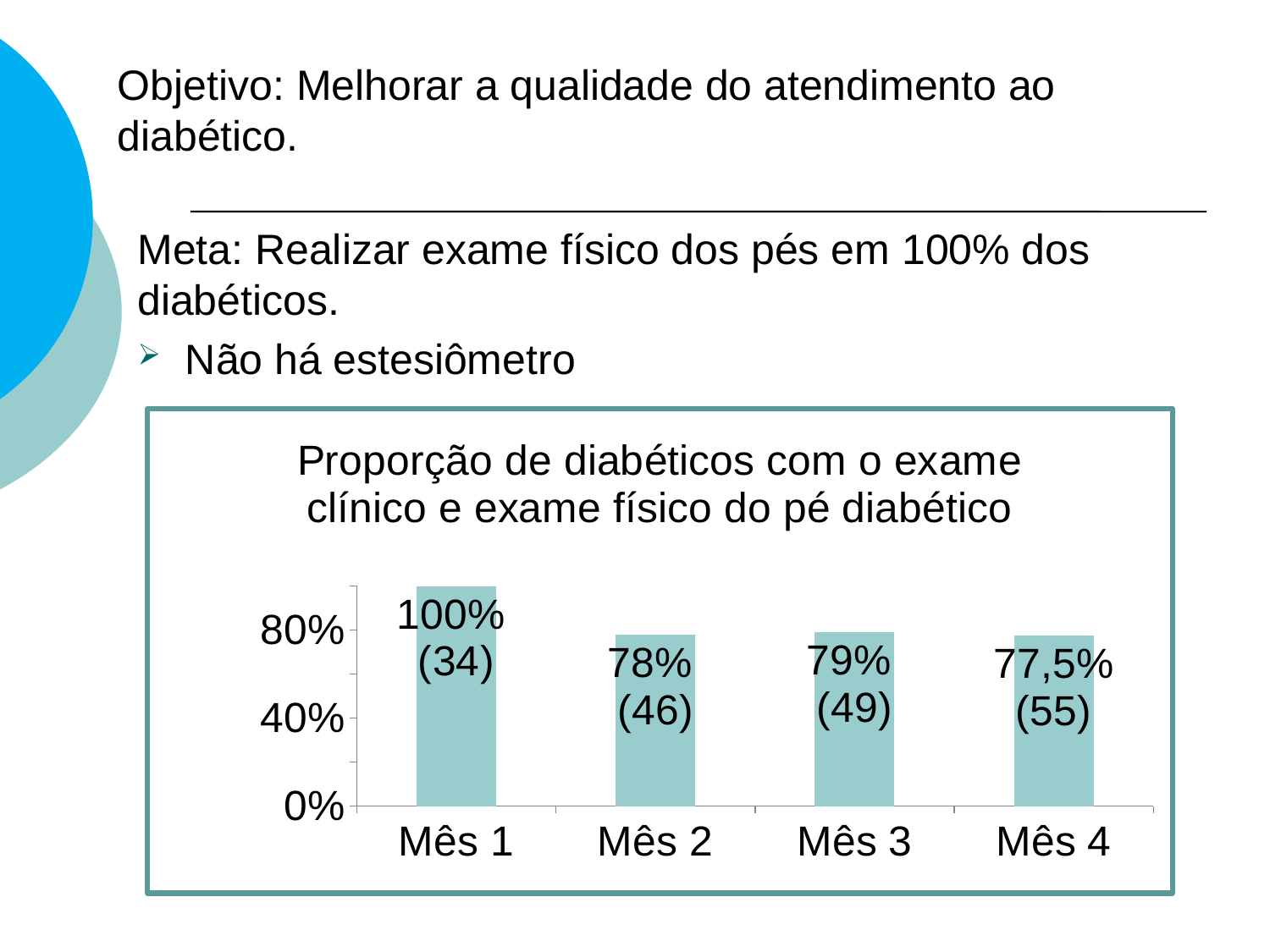
What is the percentage shown for Mês 4? 77,5% Is the value for Mês 1 greater or less than 80%? greater What is the difference in percentage points between Mês 1 and Mês 2? 22% Which month has the highest proportion? Mês 1 Which month has the lowest proportion according to the data labels? Mês 4 What is the percentage shown for Mês 2? 78% What number appears in parentheses under the percentage for Mês 3? 49 How many months are shown on the x axis? 4 Which is larger, the value for Mês 1 or the value for Mês 4? Mês 1 What kind of chart is shown on the slide? bar chart What is the percentage shown for Mês 1? 100% What is the title of the chart? Proporção de diabéticos com o exame clínico e exame físico do pé diabético